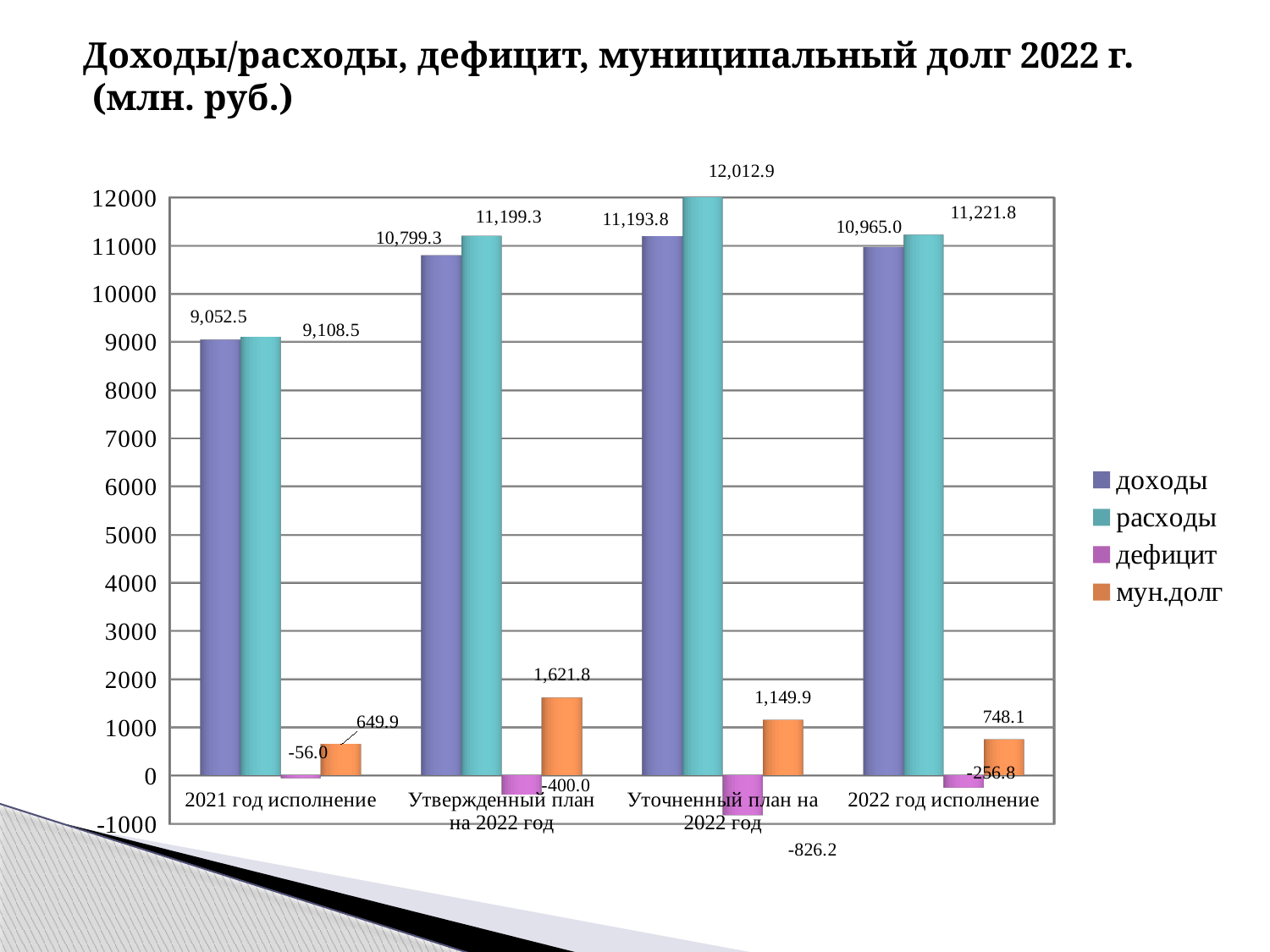
Is the value of мун.долг for Уточненный план на 2022 год greater or less than 1000? greater Which category has the lowest value of мун.долг? 2021 год исполнение What is the value of мун.долг for Утвержденный план на 2022 год? 1,621.8 What is the value of доходы for 2021 год исполнение? 9,052.5 How many series does the legend list? 4 How many categories are shown on the x axis? 4 Which is larger for Уточненный план на 2022 год: доходы or расходы? расходы Which category has the highest value of расходы? Уточненный план на 2022 год What is the value of дефицит for 2022 год исполнение? -256.8 What is the difference between расходы and доходы for 2022 год исполнение? 256.8 What is the value of расходы for Уточненный план на 2022 год? 12,012.9 What type of chart is shown on the slide? bar chart